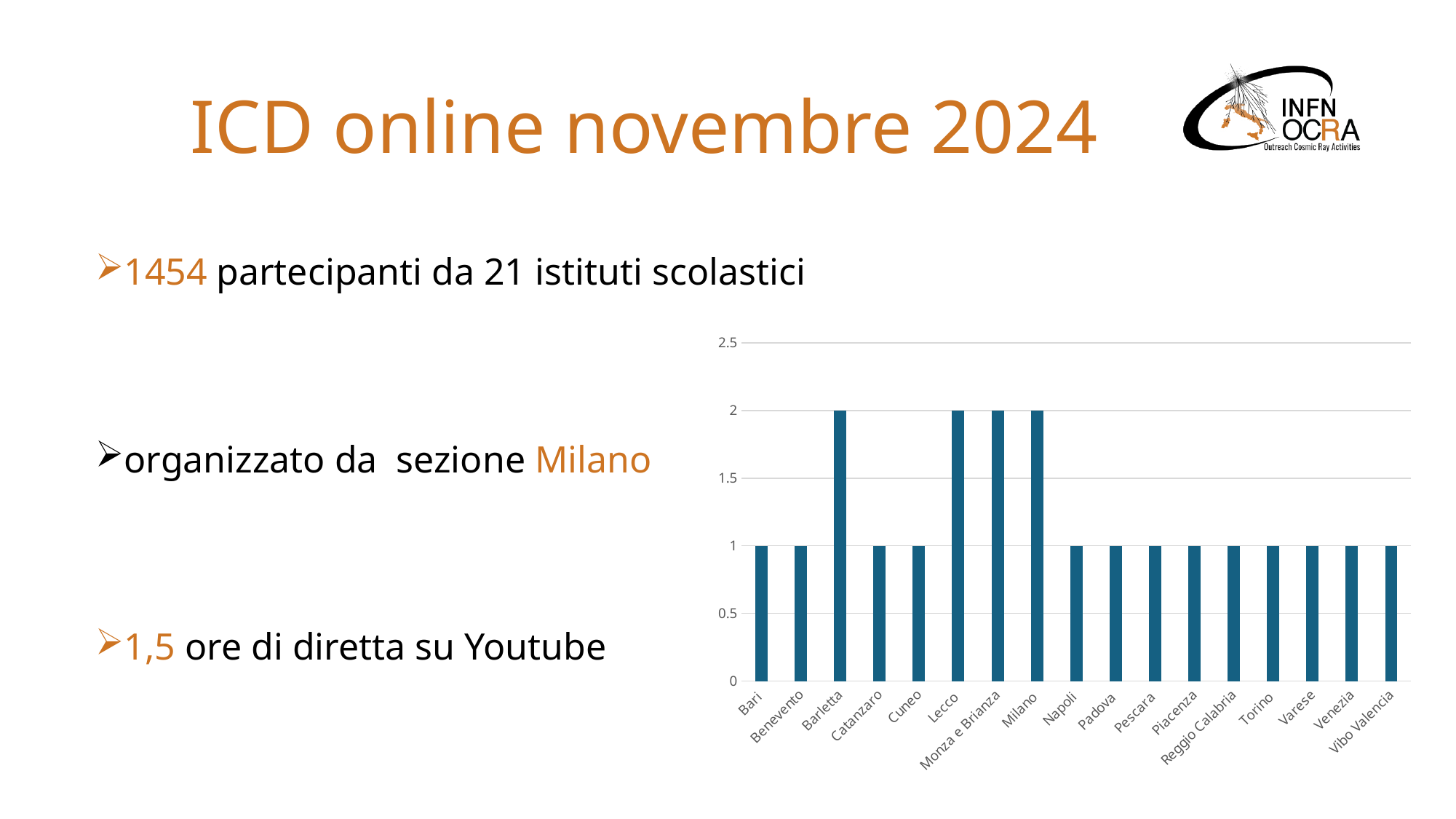
Is the value for Torino in the chart greater or less than 1.5? less What is the value for Milano in the chart? 2 Which is larger in the chart, the value for Lecco or the value for Napoli? Lecco How many categories in the chart have a value of 2? 4 What is the value for Bari in the chart? 1 How many categories are shown on the x axis of the chart? 17 What is the highest value shown on the vertical axis of the chart? 2.5 What is the value for Vibo Valencia in the chart? 1 What kind of chart is shown on the slide? bar chart What is the value for Monza e Brianza in the chart? 2 What is the value for Barletta in the chart? 2 What is the difference between the value for Barletta and the value for Catanzaro in the chart? 1